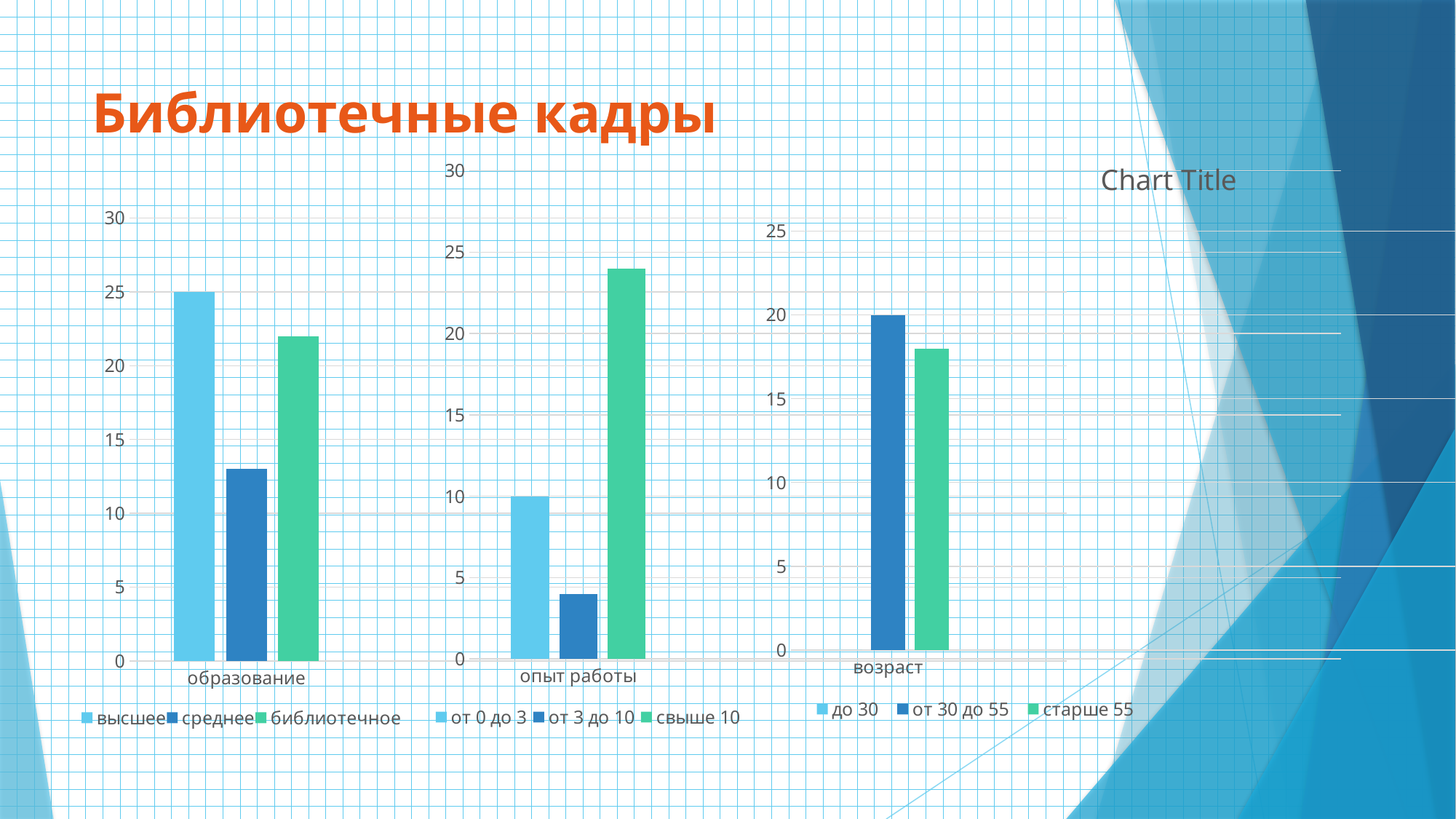
How many series does the legend of the middle chart (опыт работы) list? 3 In the left chart (образование), what is the value for высшее? 25 In the left chart (образование), which series has the lowest value? среднее In the right chart (возраст), what is the value for от 30 до 55? 20 In the middle chart (опыт работы), what is the value for от 0 до 3? 10 In the left chart (образование), is the value for среднее greater or less than 15? less What kind of chart is the left chart (образование)? bar chart In the right chart (возраст), is the value for старше 55 greater or less than 15? greater In the middle chart (опыт работы), which series has the lowest value? от 3 до 10 In the middle chart (опыт работы), which series has the highest value? свыше 10 In the middle chart (опыт работы), is the value for свыше 10 greater or less than 20? greater In the left chart (образование), which series has the highest value? высшее